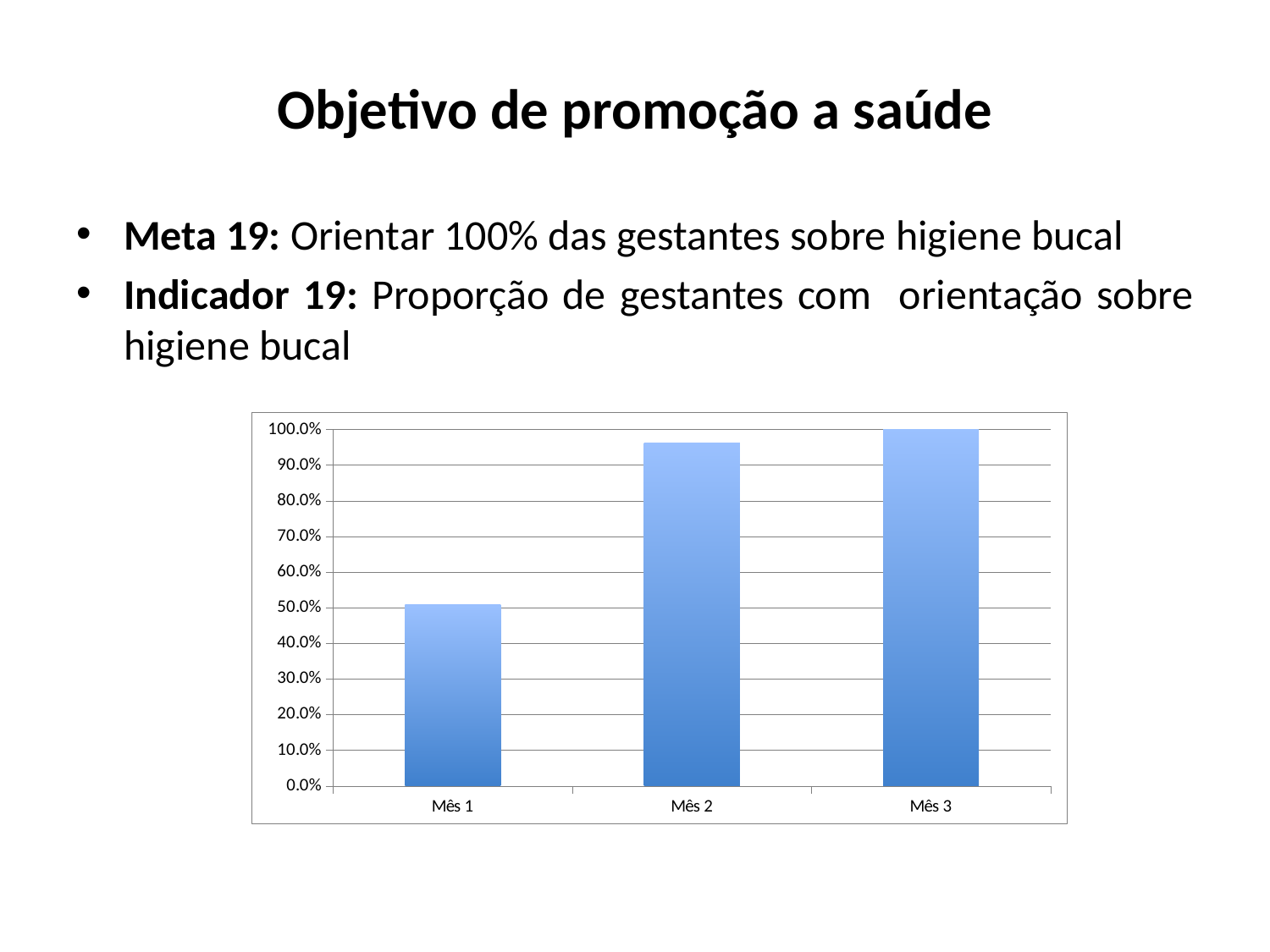
How many categories are plotted on the x axis of the chart? 3 Do the values rise or fall from Mês 1 to Mês 3? rise Which category has the highest value in the chart? Mês 3 What kind of chart is shown on the slide? bar chart Is the value for Mês 1 greater or less than 60.0%? less Which is larger, the value for Mês 1 or the value for Mês 2? Mês 2 Is the value for Mês 1 greater or less than 40.0%? greater What is the highest tick label shown on the y axis of the chart? 100.0% Which category has the lowest value in the chart? Mês 1 Is the value for Mês 2 greater or less than 90.0%? greater What is the value for Mês 3 in the chart? 100.0% What is the label of the first category on the x axis of the chart? Mês 1